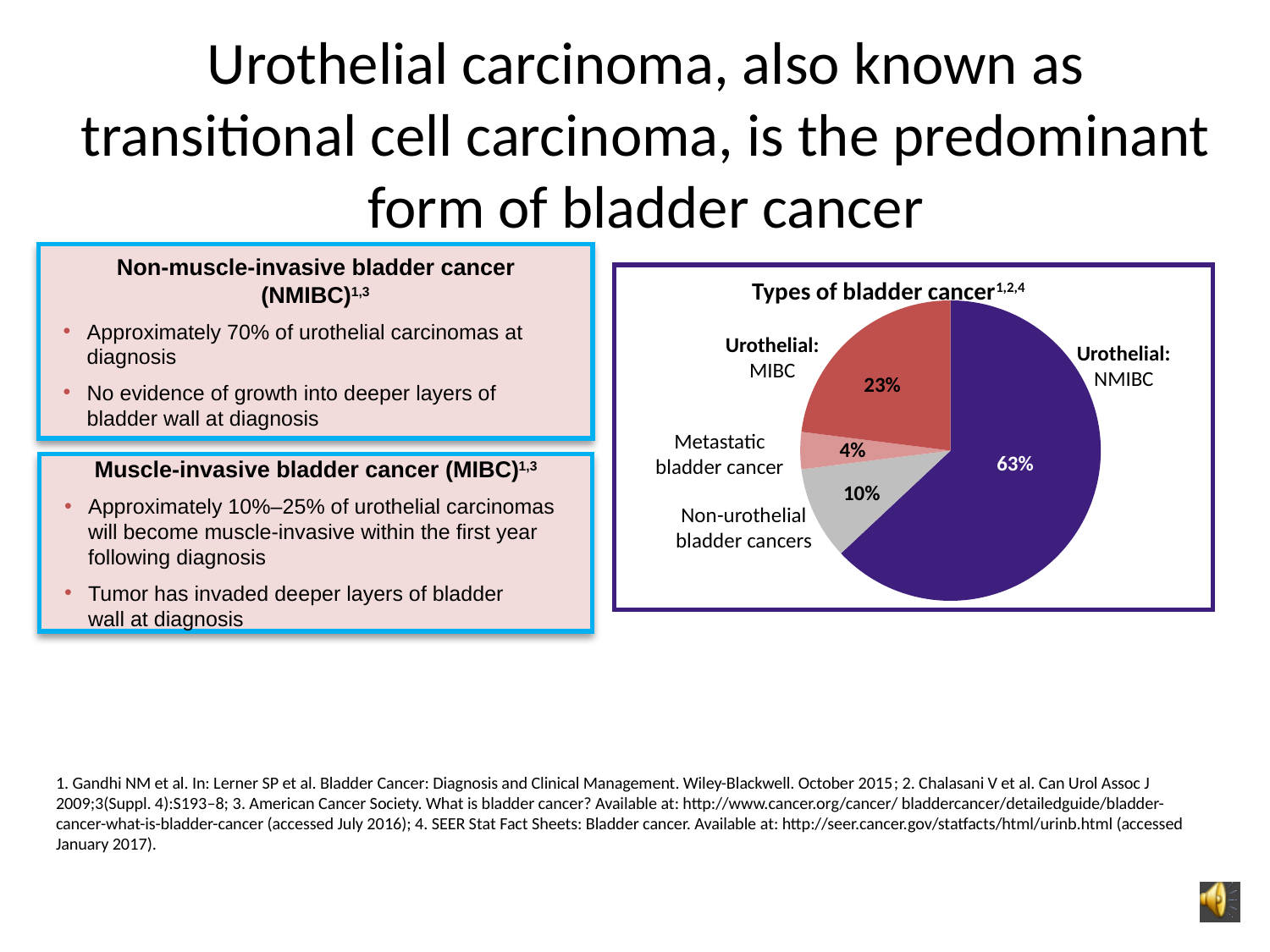
What is the title of the chart? Types of bladder cancer Which slice of the pie is the largest? Urothelial: NMIBC What is the difference in percentage points between Urothelial: NMIBC and Urothelial: MIBC? 40 What is the combined share of the two urothelial slices (NMIBC and MIBC)? 86% What percentage of the pie is Metastatic bladder cancer? 4% What kind of chart is shown on the slide? pie chart What percentage of the pie is Urothelial: NMIBC? 63% Which slice of the pie is the smallest? Metastatic bladder cancer Which is larger, the Non-urothelial bladder cancers slice or the Metastatic bladder cancer slice? Non-urothelial bladder cancers What percentage of the pie is Urothelial: MIBC? 23% What percentage of the pie is Non-urothelial bladder cancers? 10% How many slices does the pie chart have? 4